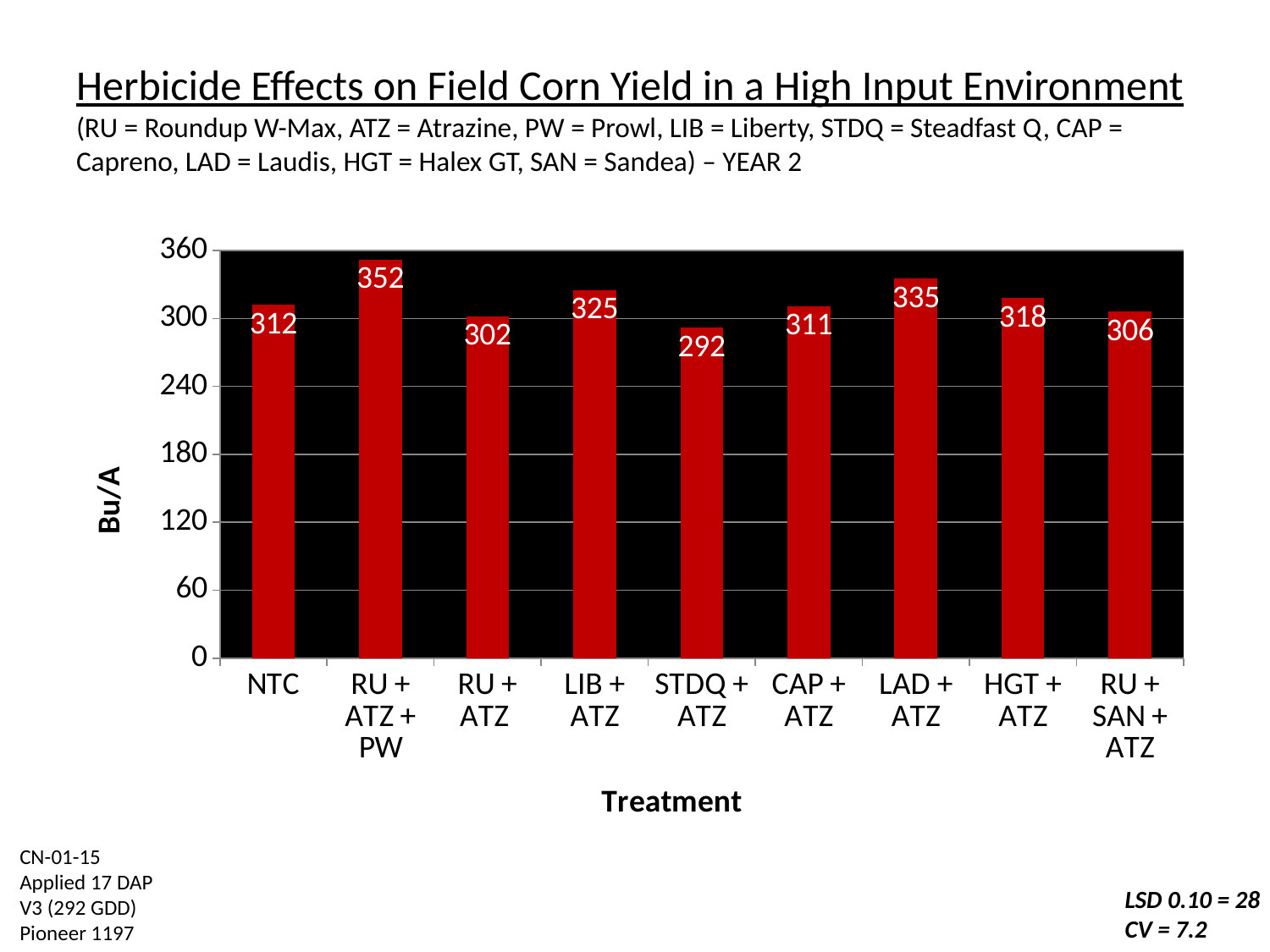
How many treatments are shown on the x axis? 9 What is the yield (Bu/A) for the STDQ + ATZ treatment? 292 What is the difference in yield between RU + ATZ + PW and STDQ + ATZ? 60 What is the yield (Bu/A) for the LAD + ATZ treatment? 335 Which treatment has the highest yield? RU + ATZ + PW What is the difference in yield between LIB + ATZ and RU + ATZ? 23 Which has a higher yield, HGT + ATZ or RU + SAN + ATZ? HGT + ATZ What kind of chart is shown on the slide? Bar chart Is the yield for CAP + ATZ greater or less than 300? greater Which treatment has the lowest yield? STDQ + ATZ What is the label of the y axis? Bu/A What is the yield (Bu/A) for the NTC treatment? 312